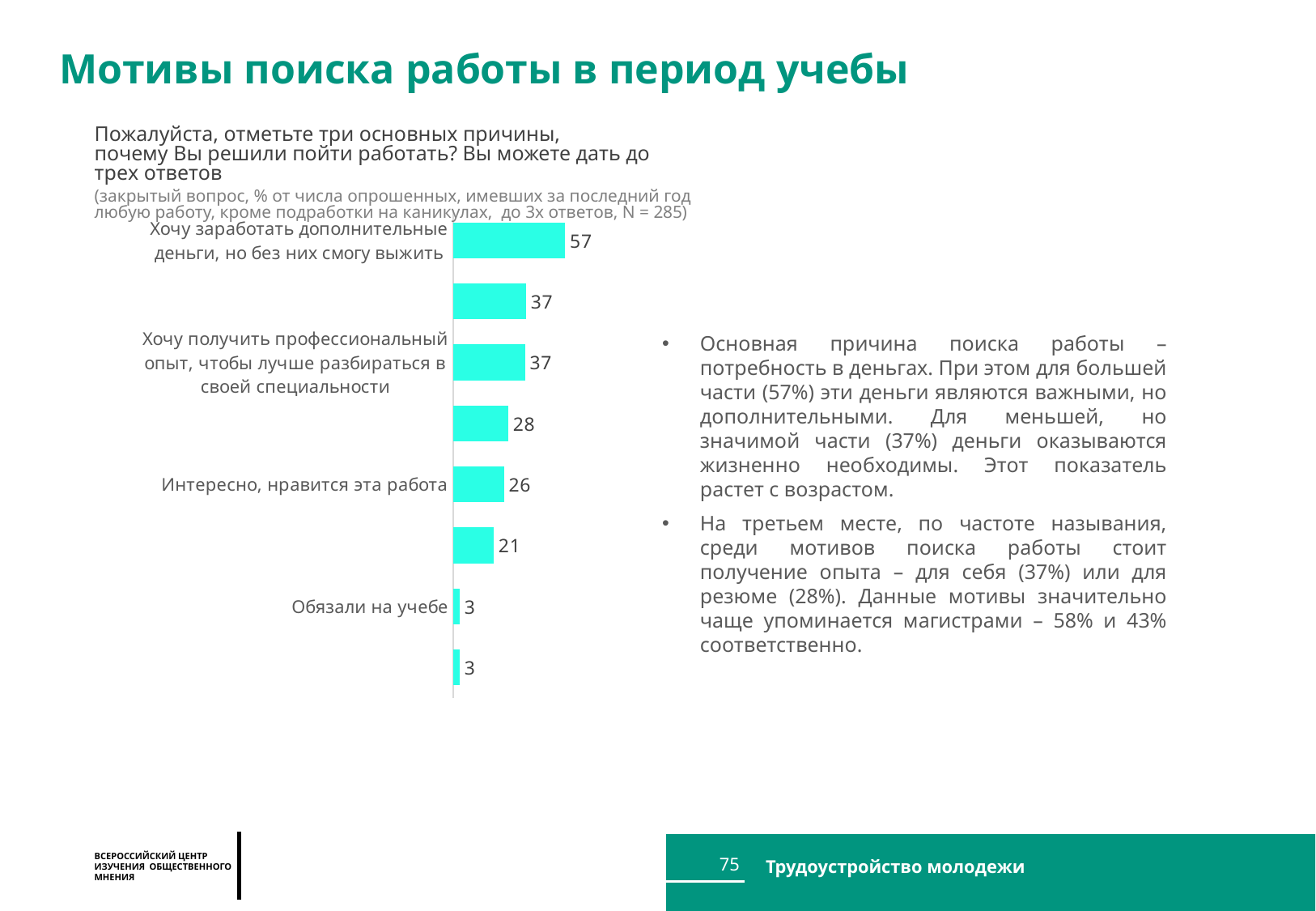
How many bars are shown in the chart? 8 What is the value for "Хочу получить профессиональный опыт, чтобы лучше разбираться в своей специальности"? 37 What is the title of the slide? Мотивы поиска работы в период учебы What is the value for "Хочу заработать дополнительные деньги, но без них смогу выжить"? 57 What kind of chart is shown on the slide? Bar chart Which is larger: the value for "Хочу получить профессиональный опыт, чтобы лучше разбираться в своей специальности" or the value for "Интересно, нравится эта работа"? Хочу получить профессиональный опыт, чтобы лучше разбираться в своей специальности Which category has the highest value? Хочу заработать дополнительные деньги, но без них смогу выжить What is the value for "Обязали на учебе"? 3 What is the highest value shown in the chart? 57 What is the value for "Интересно, нравится эта работа"? 26 What is the lowest value shown in the chart? 3 What is the difference between the values for "Хочу заработать дополнительные деньги, но без них смогу выжить" and "Интересно, нравится эта работа"? 31